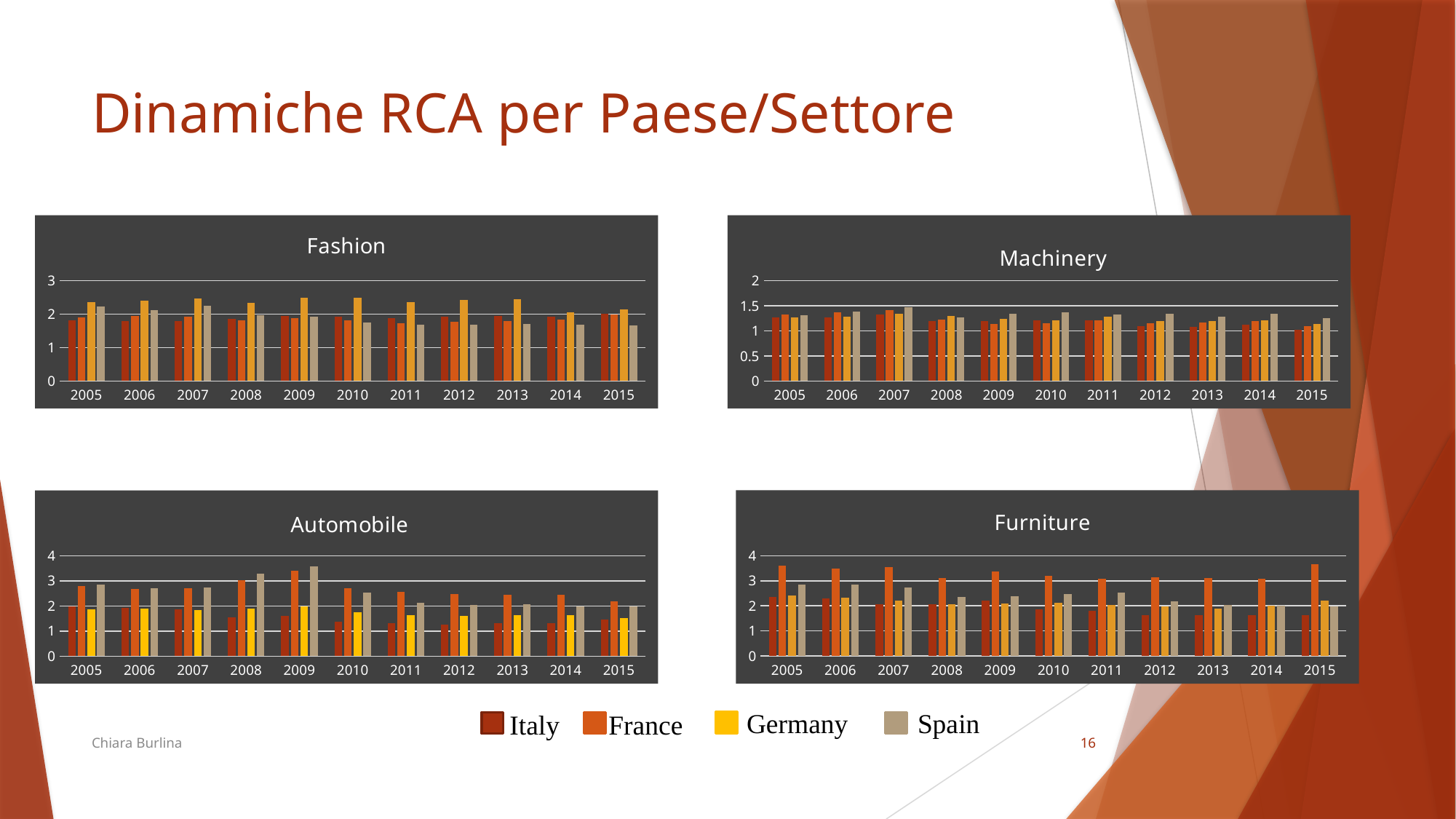
In the Furniture chart, which country has the highest value in 2015? France In the Automobile chart, which is larger in 2008, Spain or Italy? Spain How many charts are on the slide? 4 How many years are shown on the x axis of the Automobile chart? 11 In the Machinery chart, which country has the highest value in 2015? Spain In the Automobile chart, is the value for Spain in 2009 greater or less than 3? greater Which countries are listed in the legend? Italy, France, Germany, Spain What kind of chart is the Fashion chart? bar chart In the Fashion chart, is the value for Germany in 2010 greater or less than 2? greater In the Fashion chart, is the value for Spain in 2010 greater or less than 2? less In the Automobile chart, do the values for Italy rise or fall from 2005 to 2015? fall How many series does the shared legend list? 4